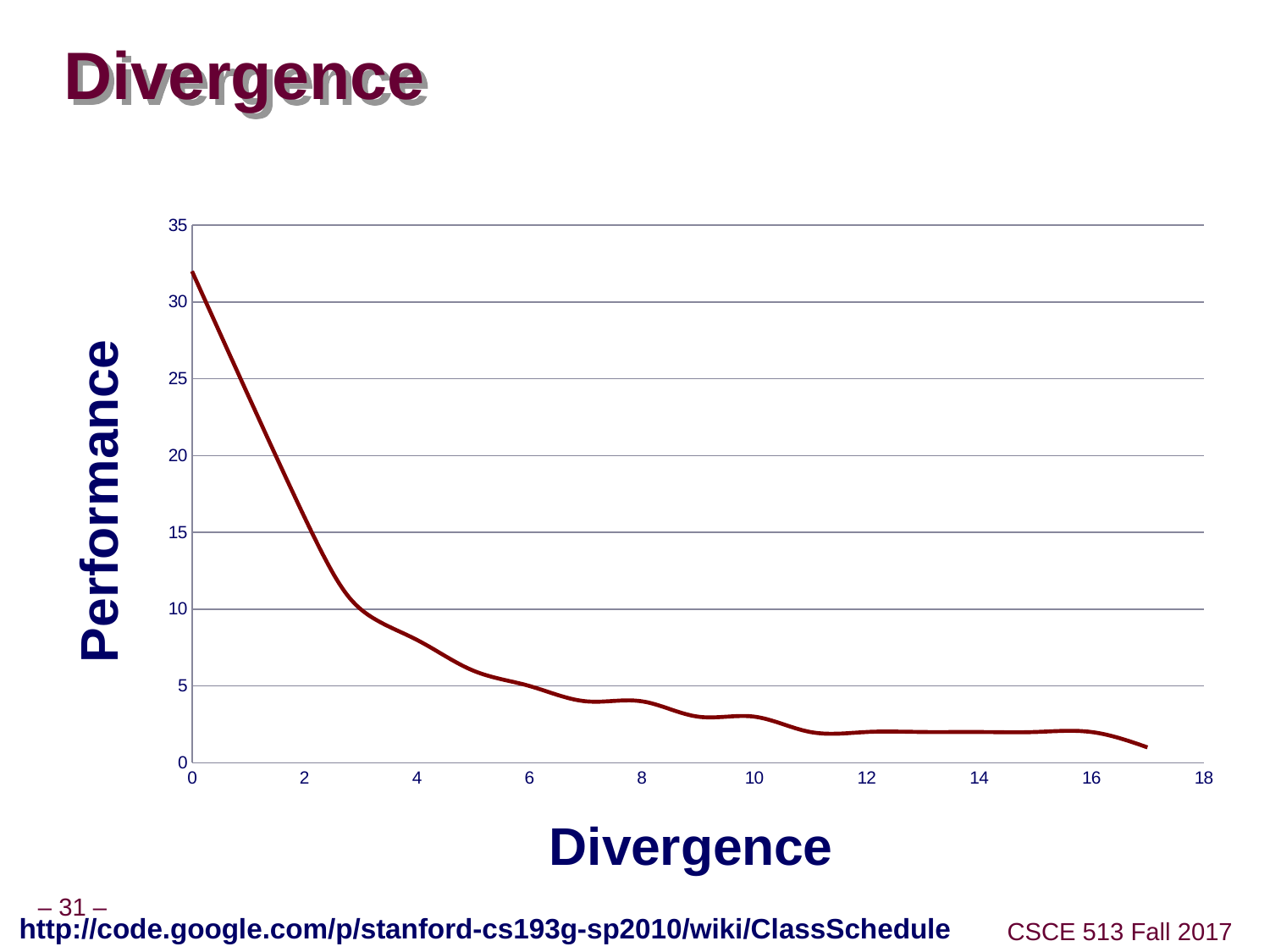
What is the label of the y axis? Performance Which is larger, the performance at divergence 0 or at divergence 16? divergence 0 Is the performance value at divergence 4 greater or less than 10? less What is the label of the x axis? Divergence Is the performance value at divergence 12 greater or less than 5? less Is the performance value at divergence 8 greater or less than 5? less At which divergence value is performance highest? 0 Does performance rise or fall as divergence increases along the x axis? fall What kind of chart is shown on the slide? line chart